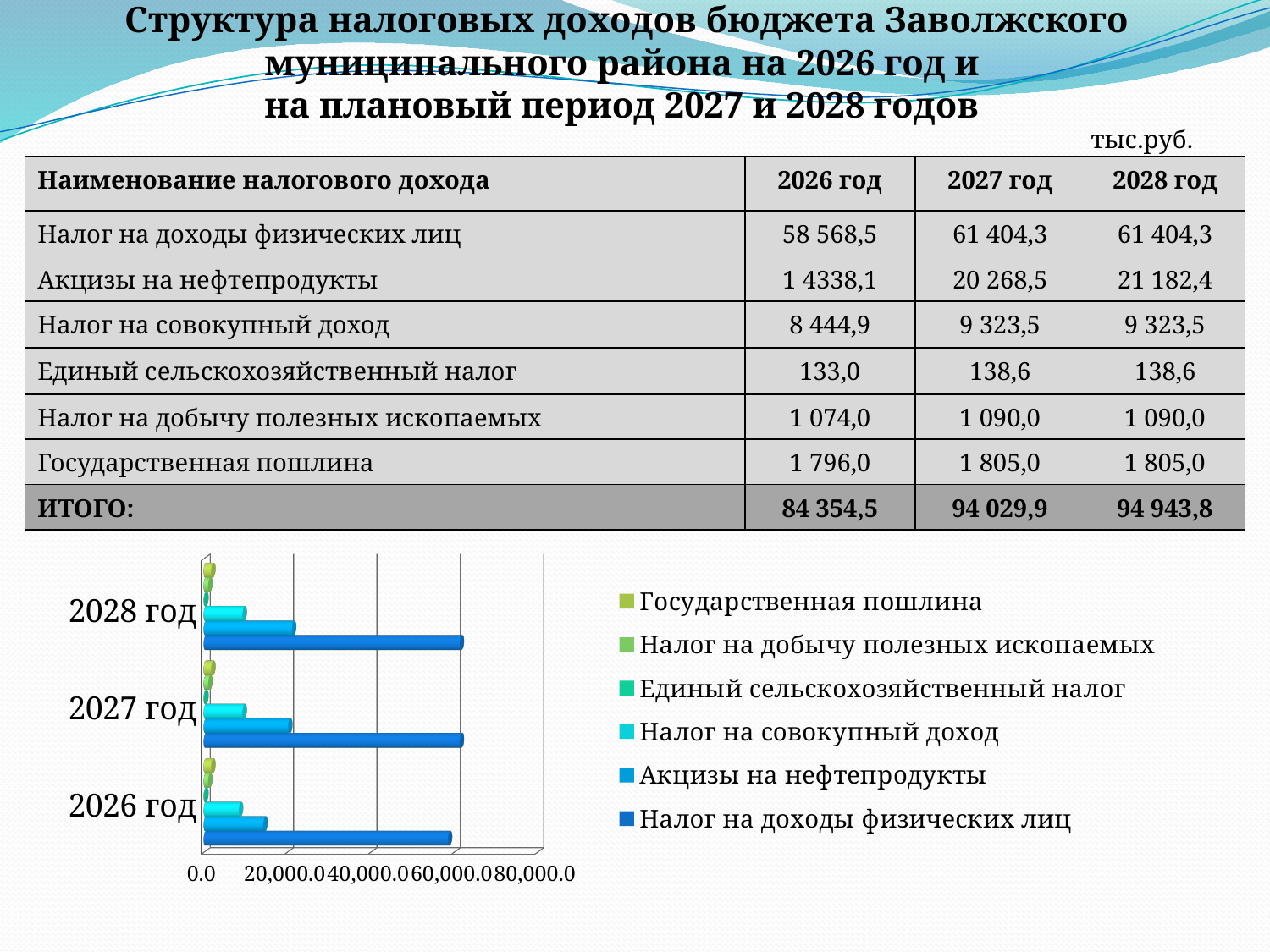
In 2028 год, which is larger: Акцизы на нефтепродукты or Налог на совокупный доход? Акцизы на нефтепродукты According to the table, what is the value of Налог на доходы физических лиц for 2027 год? 61 404,3 Which series has the longest bar for 2026 год? Налог на доходы физических лиц What kind of chart is shown at the bottom of the slide? bar chart How many series does the chart legend list? 6 What unit of measurement is stated above the table? тыс.руб. Does the bar for Акцизы на нефтепродукты rise or fall from 2026 год to 2028 год? rise Is the value for Акцизы на нефтепродукты in 2026 год greater or less than 20,000.0? less Is the value for Налог на доходы физических лиц in 2026 год greater or less than 40,000.0? greater How many year categories does the chart show? 3 Is the value for Налог на совокупный доход in 2028 год greater or less than 20,000.0? less According to the table, what is the value of Акцизы на нефтепродукты for 2028 год? 21 182,4